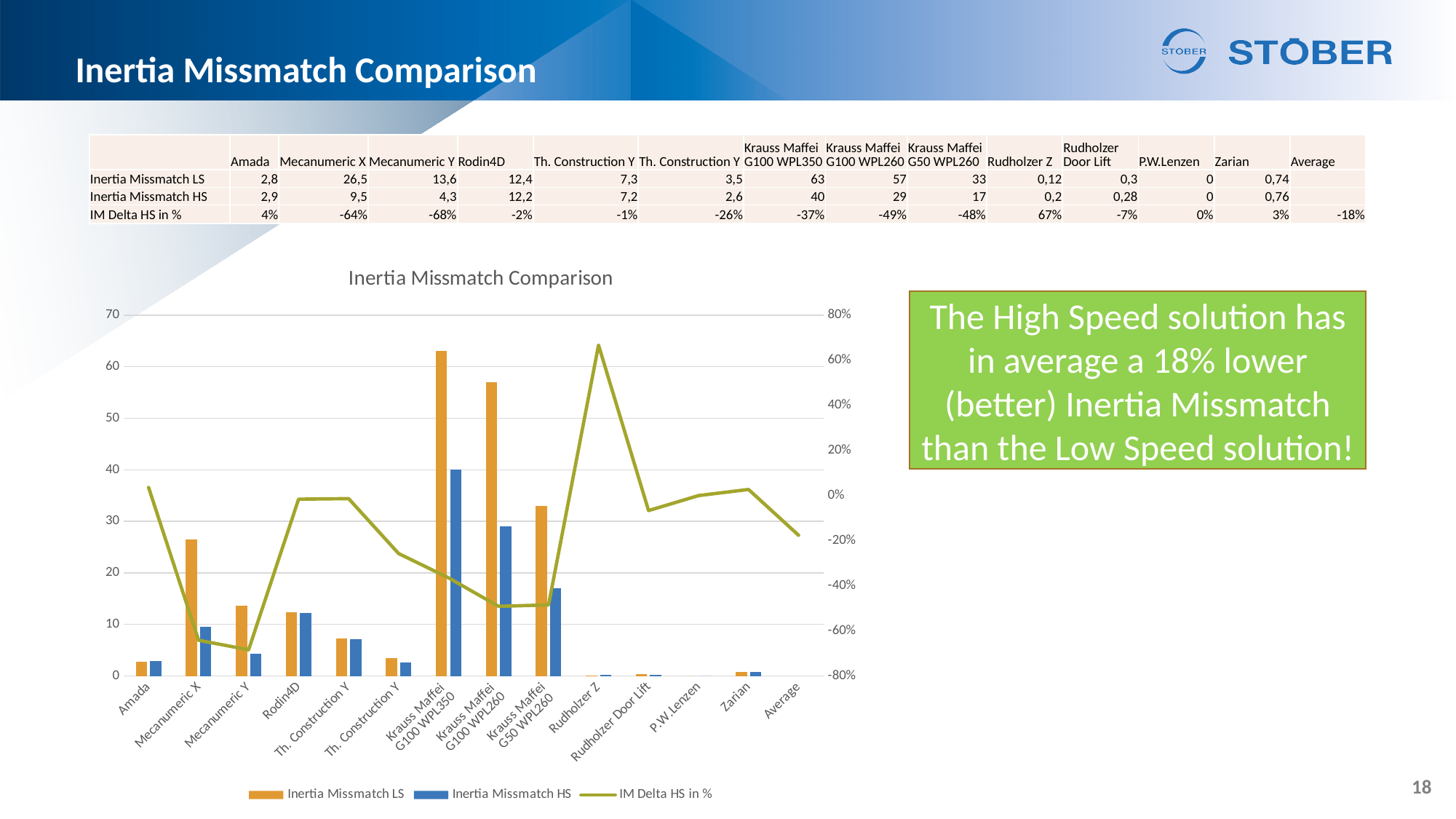
What kind of chart is shown on the slide? bar chart with a line What is the IM Delta HS in % value for the Average category? -18% Which has the larger Inertia Missmatch LS value, Mecanumeric X or Mecanumeric Y? Mecanumeric X Which category has the highest Inertia Missmatch LS value? Krauss Maffei G100 WPL350 How many series does the chart legend list? 3 What is the Inertia Missmatch LS value for Krauss Maffei G100 WPL350? 63 Which category has the lowest IM Delta HS in % value? Mecanumeric Y What is the title of the chart? Inertia Missmatch Comparison What is the IM Delta HS in % value for Rudholzer Z? 67% What is the Inertia Missmatch HS value for Mecanumeric X? 9,5 What is the difference between the Inertia Missmatch LS and HS values for Krauss Maffei G100 WPL260? 28 How many categories are shown on the x axis of the chart? 14